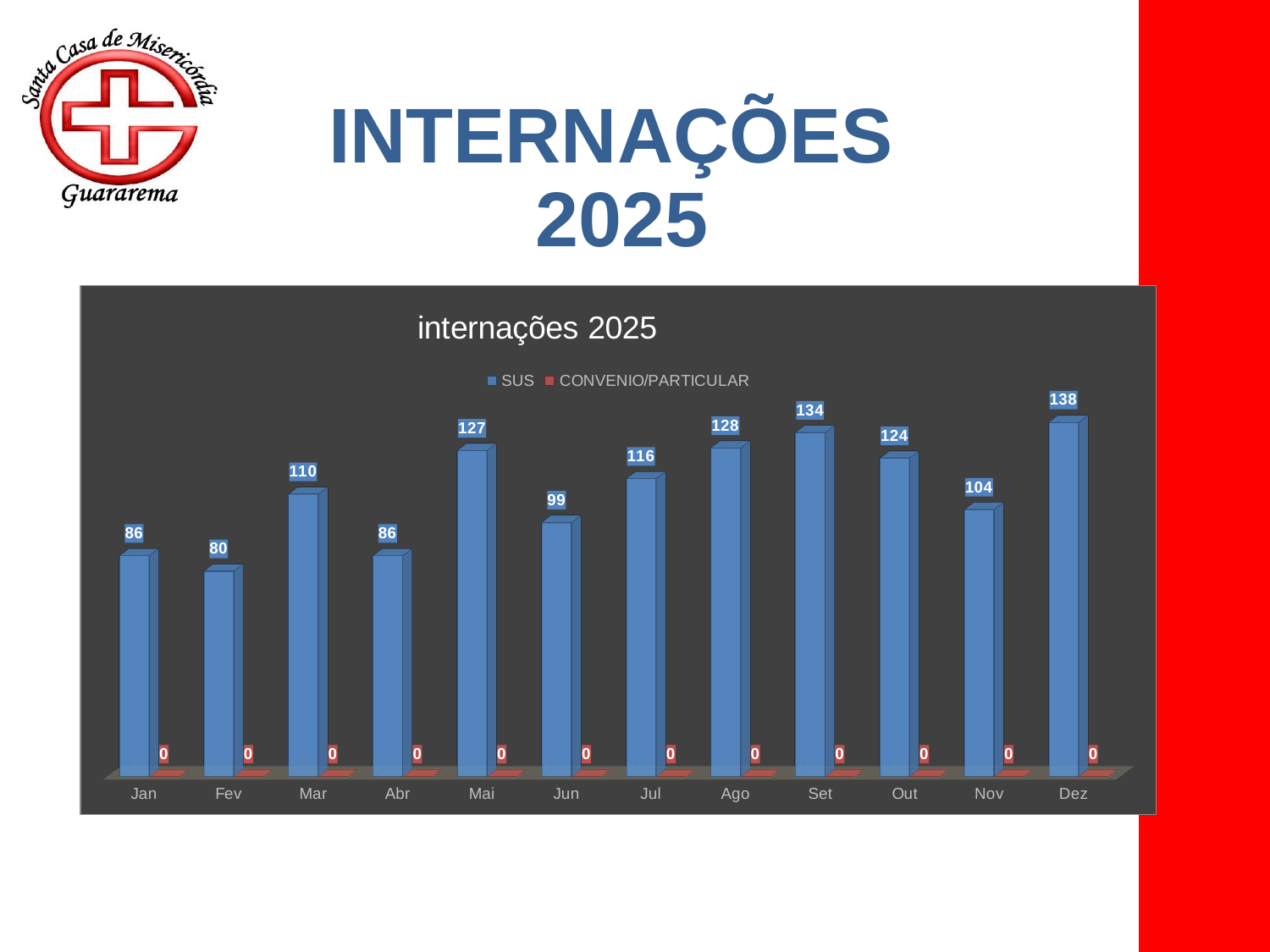
What is the CONVENIO/PARTICULAR value for Jul? 0 What is the SUS value for Set? 134 Which month has the highest SUS value? Dez What is the difference between the SUS values for Dez and Jan? 52 Which has a larger SUS value, Mai or Ago? Ago Which series is shown in red in the legend? CONVENIO/PARTICULAR How many series does the legend list? 2 How many months are shown on the x axis? 12 Which month has the lowest SUS value? Fev What is the SUS value for Mar? 110 What is the title of the chart? internações 2025 What kind of chart is shown? bar chart